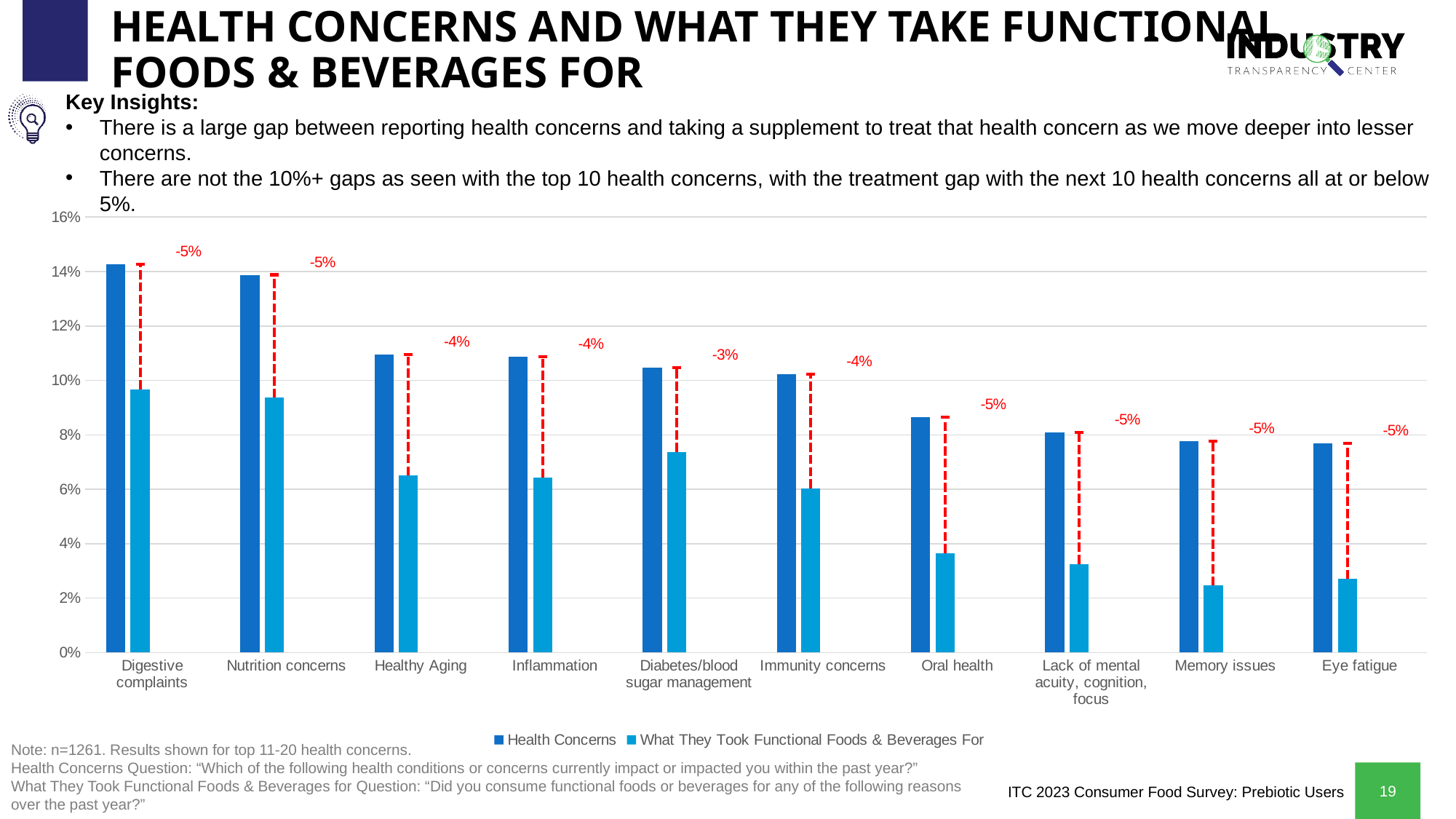
What gap value is labelled above the bars for Diabetes/blood sugar management? -3% Is the Health Concerns value for Nutrition concerns greater or less than 12%? greater How many health concern categories are shown on the x axis of the chart? 10 What type of chart is shown on the slide? bar chart What gap value is labelled above the bars for Digestive complaints? -5% Do the Health Concerns values generally rise or fall moving from left to right across the categories? fall How many series does the chart legend list? 2 Is the Health Concerns value for Eye fatigue greater or less than 8%? less What gap value is labelled above the bars for Immunity concerns? -4% Which has a higher Health Concerns value: Healthy Aging or Oral health? Healthy Aging Is the What They Took Functional Foods & Beverages For value for Memory issues greater or less than 4%? less Which category has the smallest labelled gap between Health Concerns and What They Took Functional Foods & Beverages For? Diabetes/blood sugar management